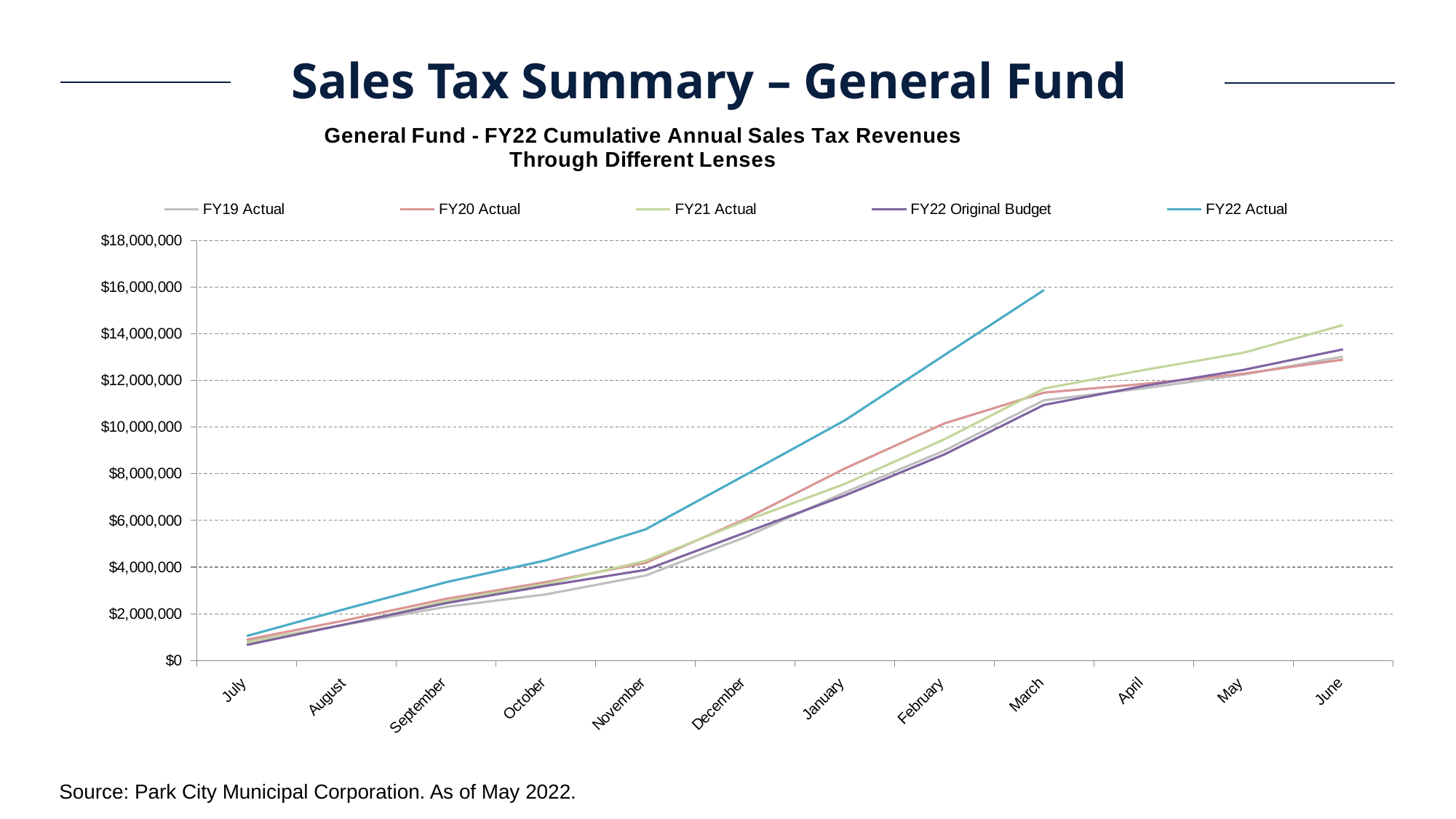
Does the FY22 Actual line rise or fall from July to March? Rise Is the value for FY22 Actual in January greater or less than $8,000,000? greater Which series has the highest value in June? FY21 Actual Which series has the highest value in March? FY22 Actual What is the title of the chart? General Fund - FY22 Cumulative Annual Sales Tax Revenues Through Different Lenses Is the value for FY22 Actual in March greater or less than $14,000,000? greater What kind of chart is shown on the slide? Line chart How many months are shown along the x axis of the chart? 12 In which month does the FY22 Actual line end? March Is the value for FY22 Original Budget in December greater or less than $8,000,000? less How many series does the chart legend list? 5